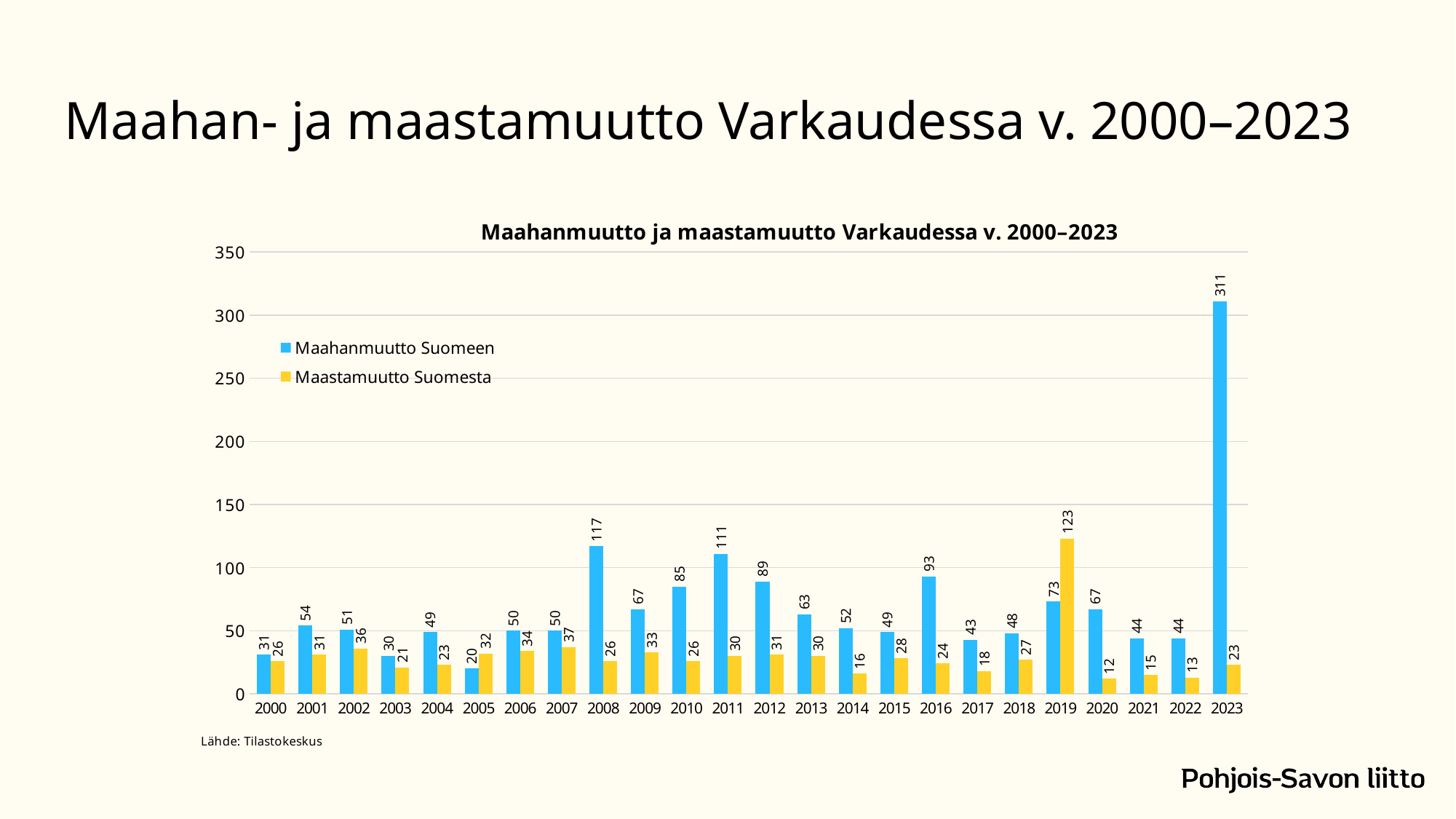
What kind of chart is shown on the slide? Bar chart In 2005, which is larger: Maahanmuutto Suomeen or Maastamuutto Suomesta? Maastamuutto Suomesta What is the value of Maahanmuutto Suomeen in 2008? 117 How many years are shown on the x axis of the chart? 24 What is the value of Maahanmuutto Suomeen in 2023? 311 Is the value for Maahanmuutto Suomeen in 2011 greater or less than 100? greater How many series does the legend list? 2 What is the difference between Maahanmuutto Suomeen and Maastamuutto Suomesta in 2019? 50 What is the value of Maastamuutto Suomesta in 2019? 123 Which year has the highest value for Maahanmuutto Suomeen? 2023 Which year has the lowest value for Maastamuutto Suomesta? 2020 Which year has the lowest value for Maahanmuutto Suomeen? 2005